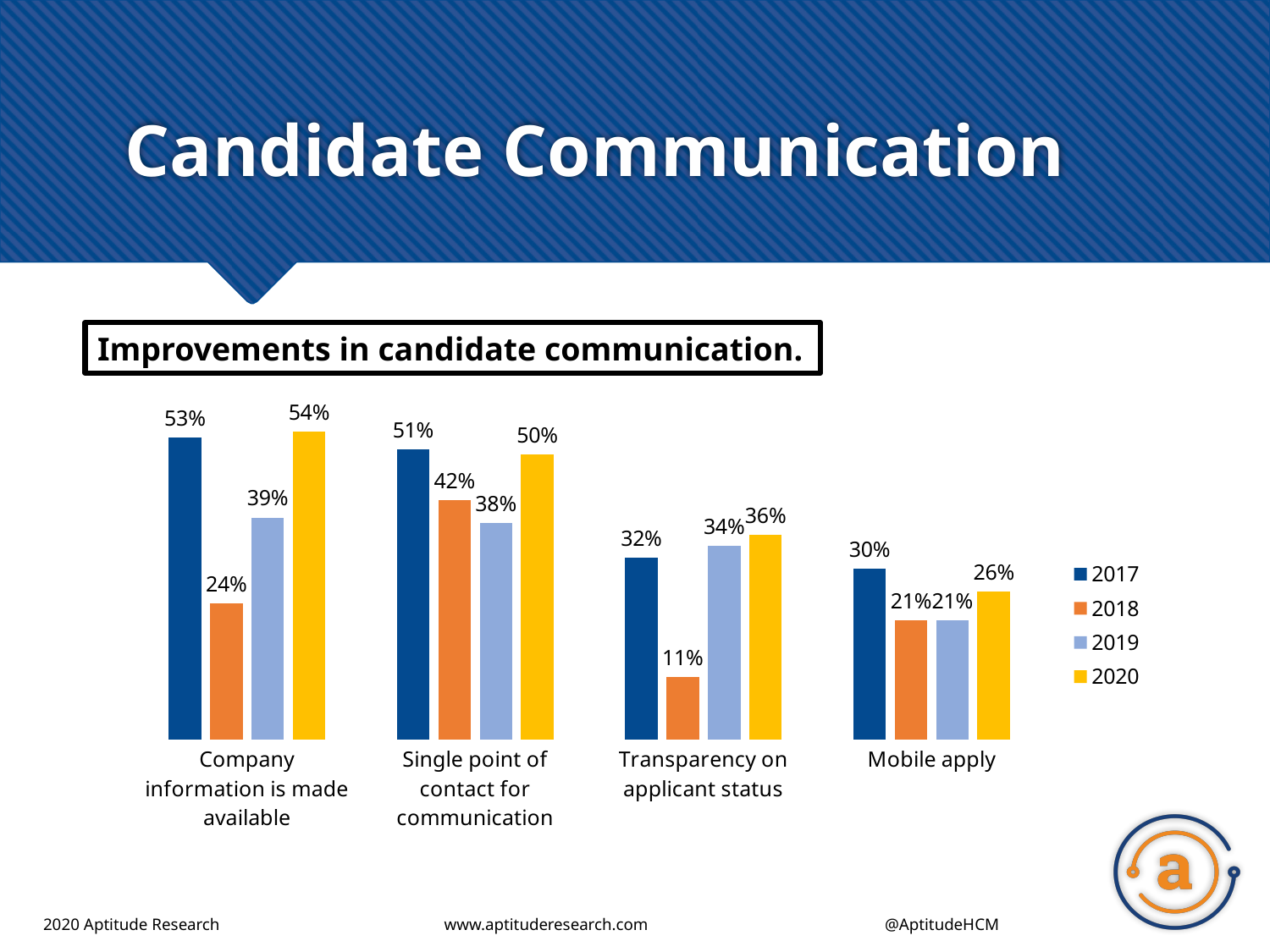
What kind of chart is shown on the slide? Bar chart Which category has the highest 2017 value? Company information is made available Which colour represents the 2020 series in the legend? Yellow What is the 2020 value for Company information is made available? 54% What is the difference between the 2017 and 2018 values for Company information is made available? 29% Which category has the lowest 2018 value? Transparency on applicant status How many series does the legend list? 4 What is the 2017 value for Mobile apply? 30% Which is larger for Single point of contact for communication: the 2018 value or the 2019 value? 2018 What is the 2019 value for Single point of contact for communication? 38% How many categories are shown on the x axis? 4 What is the 2018 value for Transparency on applicant status? 11%